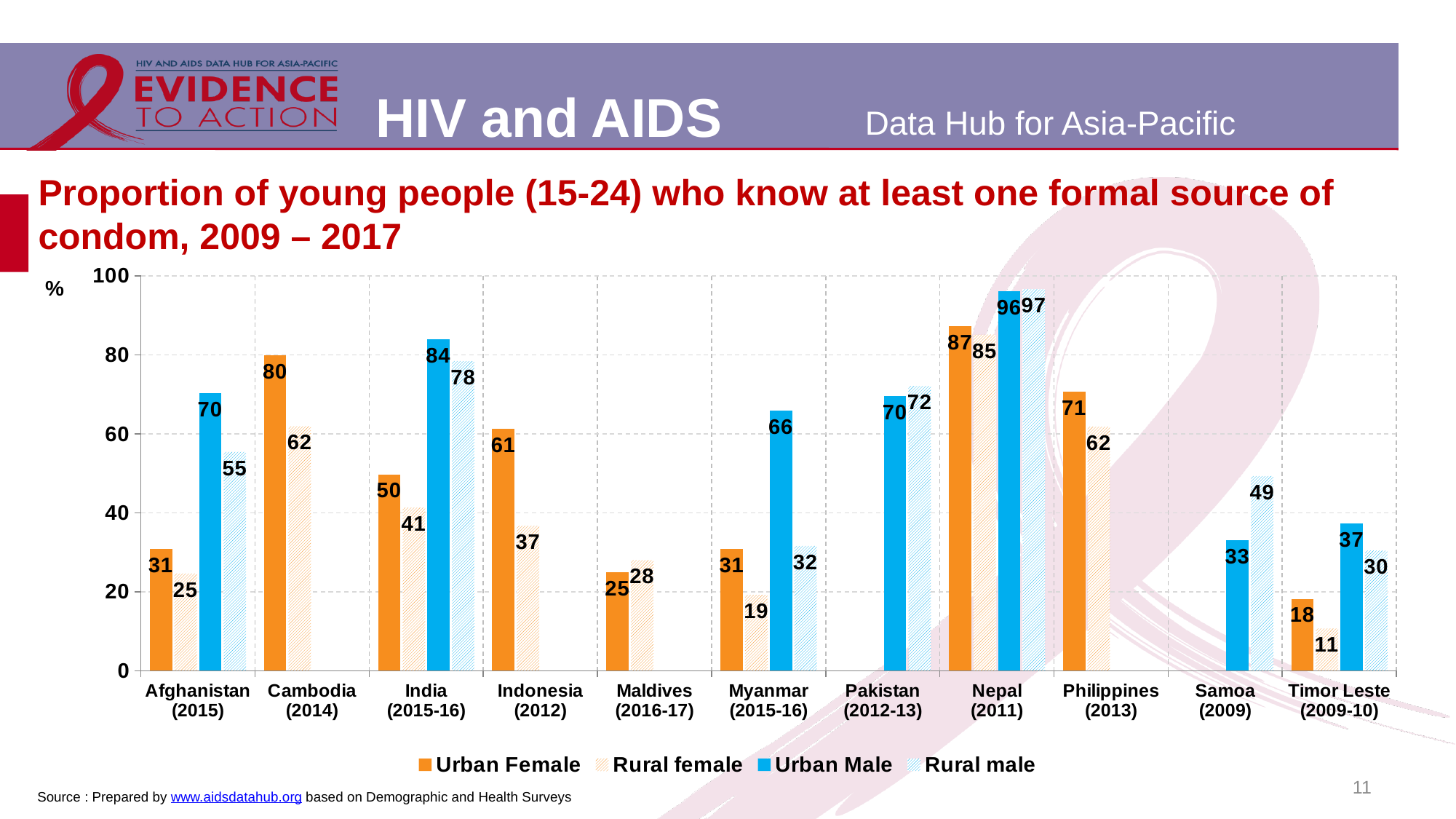
Which country has the lowest Rural female value? Timor Leste (2009-10) How many series does the legend list? 4 Is the Urban Female value for Cambodia (2014) greater or less than 60? greater Which country has the highest Urban Female value? Nepal (2011) What kind of chart is shown on the slide? Bar chart What is the Rural male value for Samoa (2009)? 49 What is the difference between the Urban Male and Urban Female values for Afghanistan (2015)? 39 What is the difference between the Rural female and Urban Female values for Maldives (2016-17)? 3 How many countries are shown on the x axis? 11 What is the Urban Male value for India (2015-16)? 84 Which is larger for Pakistan (2012-13), the Urban Male value or the Rural male value? Rural male What is the Rural female value for Myanmar (2015-16)? 19